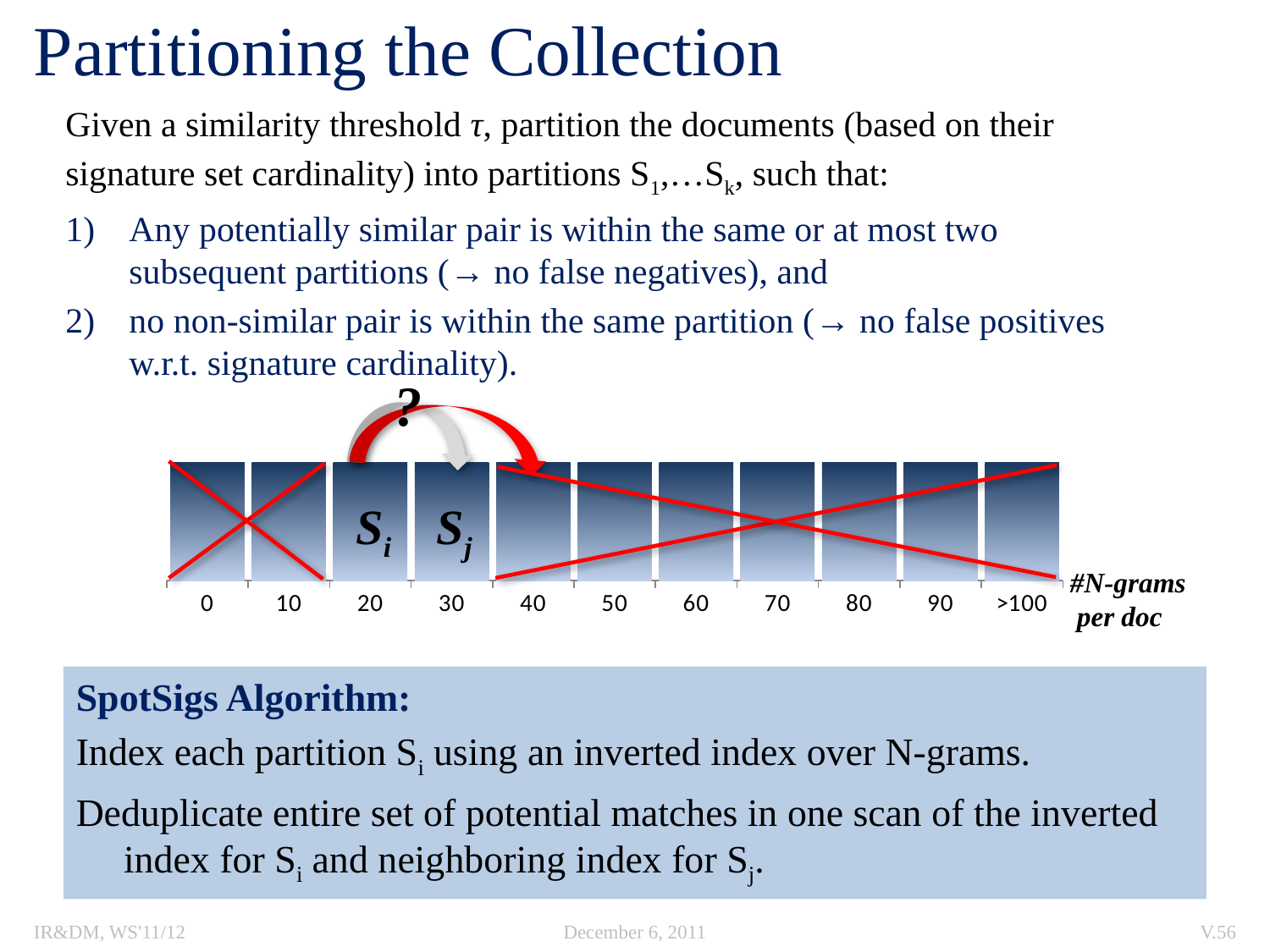
What is the label of the x axis of the chart? #N-grams per doc What is the label of the first category on the x axis? 0 Which x-axis category is the bar labelled S_j positioned above? 30 Do the bar heights rise, fall, or stay the same along the x axis? stay the same What kind of chart is shown on the slide? bar chart What is the label of the last category on the x axis? >100 How many bars (partitions) are shown in the chart? 11 Which x-axis category is the bar labelled S_i positioned above? 20